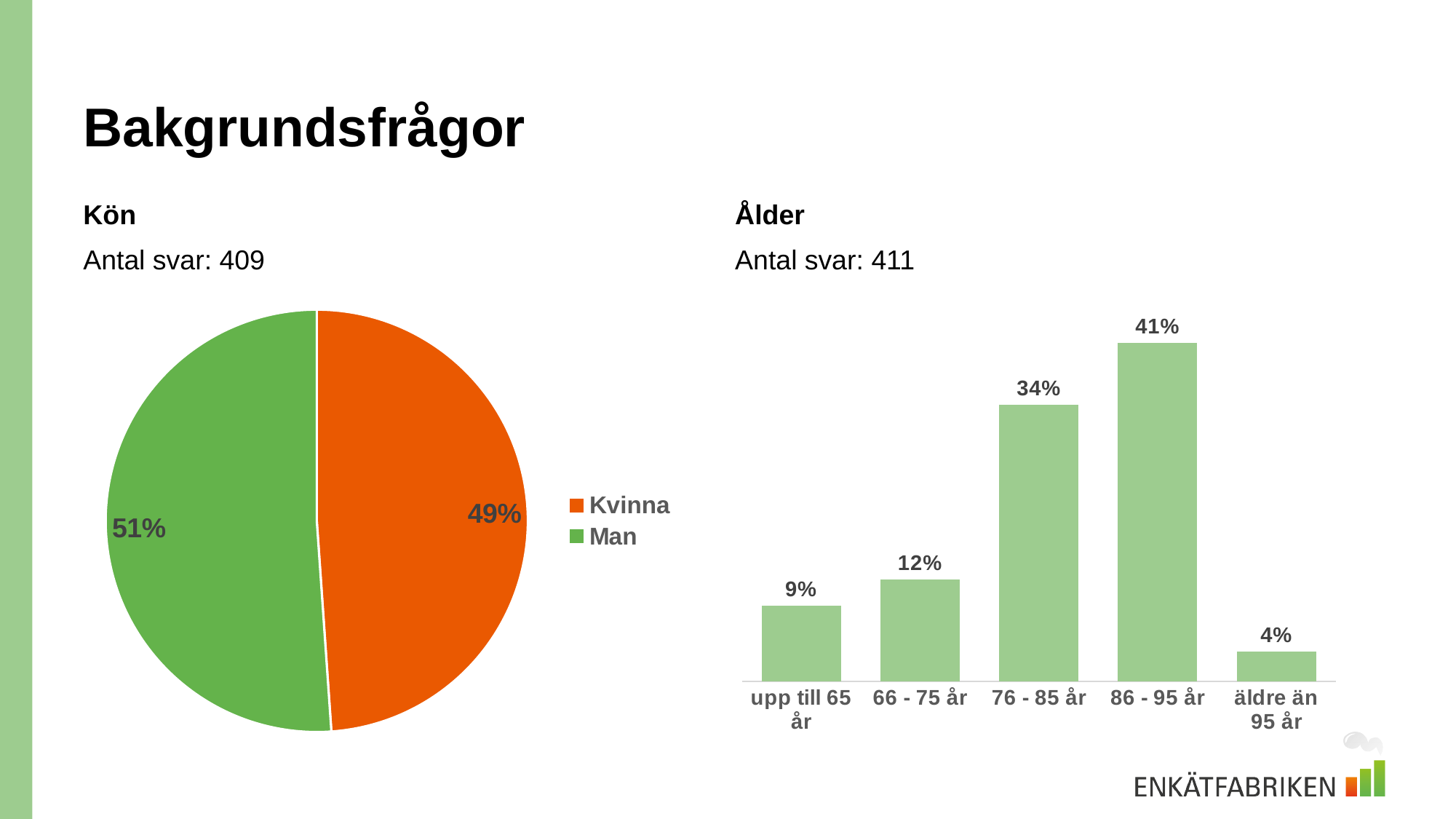
How many entries does the legend of the Kön chart list? 2 In the Kön pie chart, which slice is larger, Kvinna or Man? Man What kind of chart is the Kön chart? Pie chart How many age categories are shown in the Ålder chart? 5 In the Ålder chart, what is the value for upp till 65 år? 9% In the Kön pie chart, what share of respondents are Kvinna? 49% In the Ålder chart, which age group has the lowest value? äldre än 95 år In the Ålder chart, what is the difference between the values for 86 - 95 år and 66 - 75 år? 29% What kind of chart is the Ålder chart? Bar chart In the Ålder chart, what is the value for 76 - 85 år? 34% In the Kön pie chart, what share of respondents are Man? 51% In the Ålder chart, which age group has the highest value? 86 - 95 år